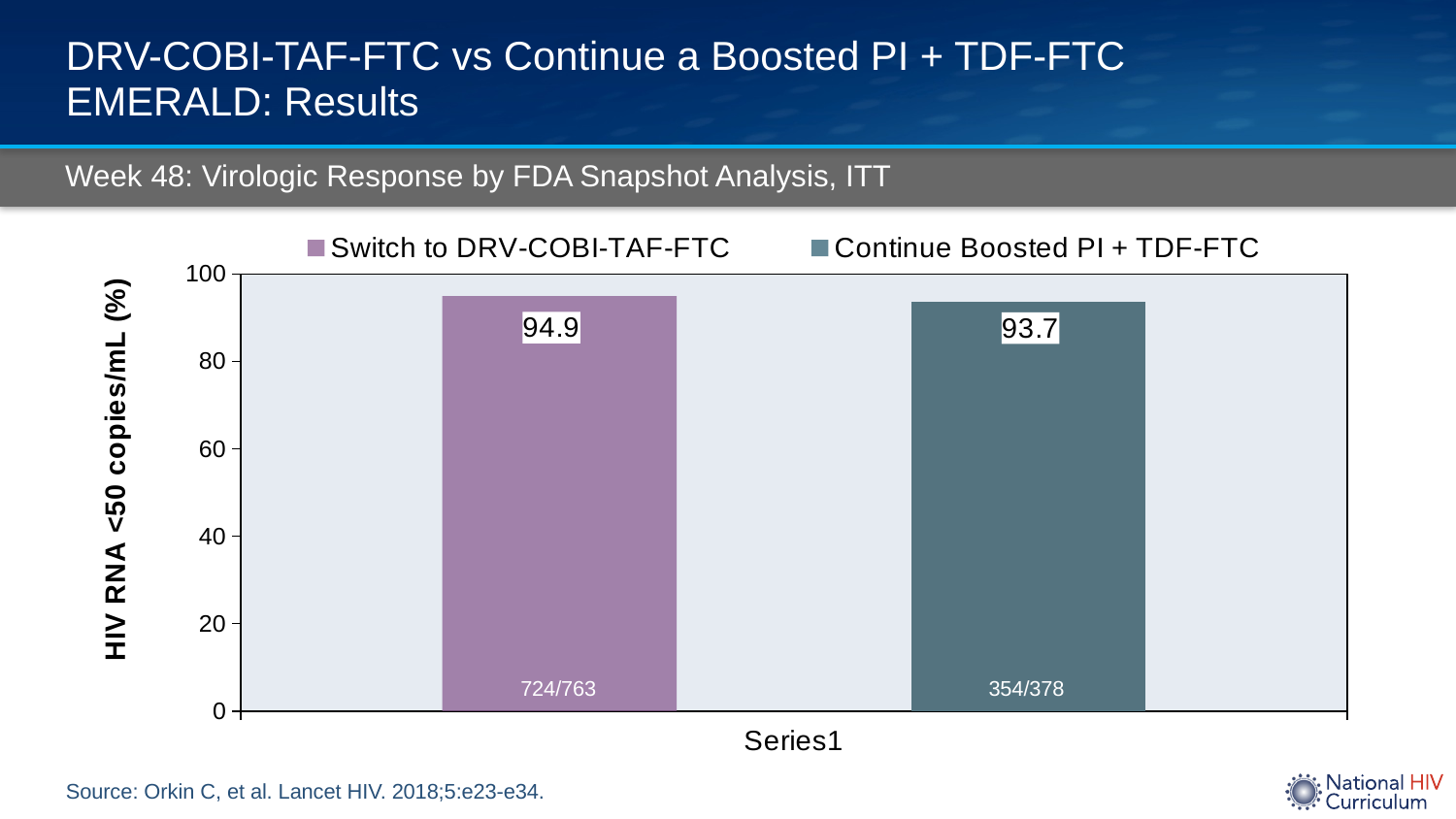
What fraction of participants is shown inside the Continue Boosted PI + TDF-FTC bar? 354/378 What is the value for Continue Boosted PI + TDF-FTC? 93.7 What is the difference between the Switch to DRV-COBI-TAF-FTC value and the Continue Boosted PI + TDF-FTC value? 1.2 What is the y-axis label of the chart? HIV RNA <50 copies/mL (%) How many series does the legend list? 2 What is the maximum value shown on the y-axis? 100 Which series has the higher value, Switch to DRV-COBI-TAF-FTC or Continue Boosted PI + TDF-FTC? Switch to DRV-COBI-TAF-FTC Is the value for Continue Boosted PI + TDF-FTC greater or less than 80? greater What kind of chart is shown on the slide? Bar chart What fraction of participants is shown inside the Switch to DRV-COBI-TAF-FTC bar? 724/763 What is the value for Switch to DRV-COBI-TAF-FTC? 94.9